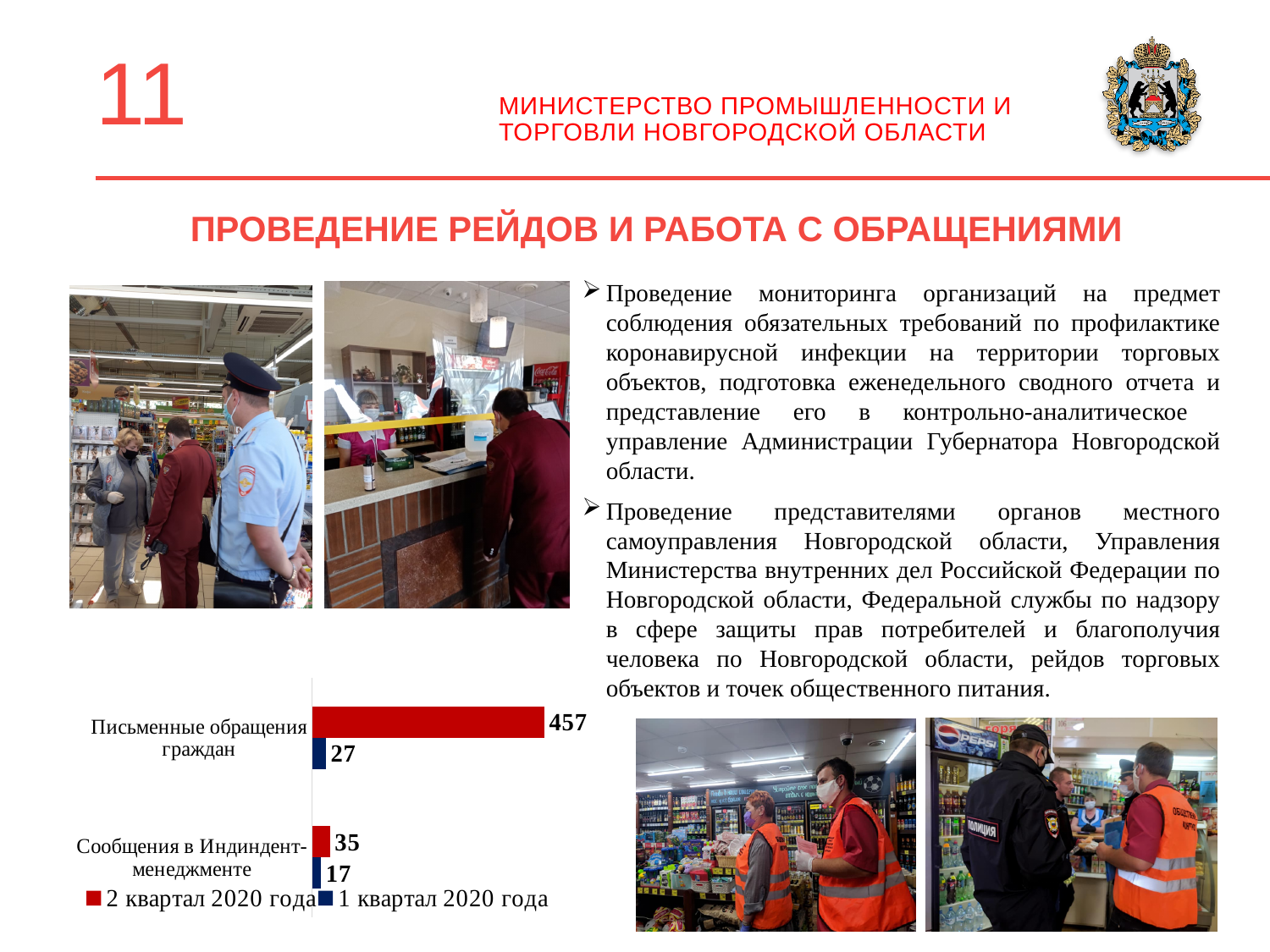
What type of chart is shown on the slide? bar chart What is the value for Сообщения в Индиндент-менеджменте in 2 квартал 2020 года? 35 Which category has the lowest value in 1 квартал 2020 года? Сообщения в Индиндент-менеджменте What is the value for Письменные обращения граждан in 1 квартал 2020 года? 27 What is the value for Сообщения в Индиндент-менеджменте in 1 квартал 2020 года? 17 Which is larger for Сообщения в Индиндент-менеджменте: the value for 2 квартал 2020 года or for 1 квартал 2020 года? 2 квартал 2020 года Which colour represents 1 квартал 2020 года in the chart? blue Which category has the highest value in 2 квартал 2020 года? Письменные обращения граждан How many categories are shown in the chart? 2 What is the difference between the 2 квартал 2020 года and 1 квартал 2020 года values for Письменные обращения граждан? 430 How many series does the chart legend list? 2 What is the value for Письменные обращения граждан in 2 квартал 2020 года? 457